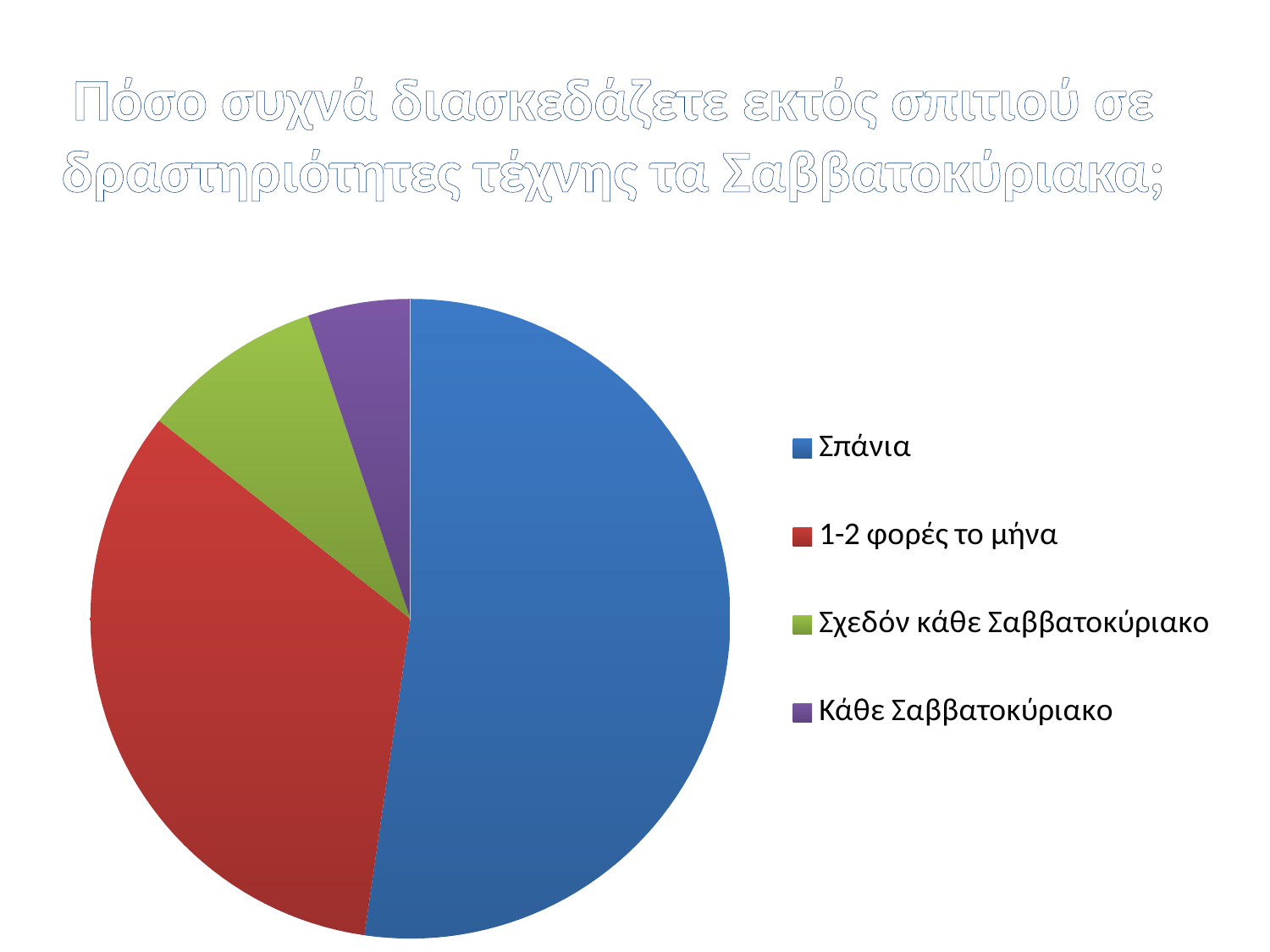
Which slice is larger: Σχεδόν κάθε Σαββατοκύριακο or Κάθε Σαββατοκύριακο? Σχεδόν κάθε Σαββατοκύριακο How many entries does the legend list? 4 Which slice is larger: Σπάνια or 1-2 φορές το μήνα? Σπάνια Which category is the second largest slice of the pie? 1-2 φορές το μήνα Which category has the smallest slice of the pie? Κάθε Σαββατοκύριακο How many categories (slices) does the pie chart have? 4 Which slice is larger: 1-2 φορές το μήνα or Σχεδόν κάθε Σαββατοκύριακο? 1-2 φορές το μήνα Which category has the largest slice of the pie? Σπάνια What is the title of the slide? Πόσο συχνά διασκεδάζετε εκτός σπιτιού σε δραστηριότητες τέχνης τα Σαββατοκύριακα; What colour is the slice for Σχεδόν κάθε Σαββατοκύριακο? green What kind of chart is shown on the slide? pie chart